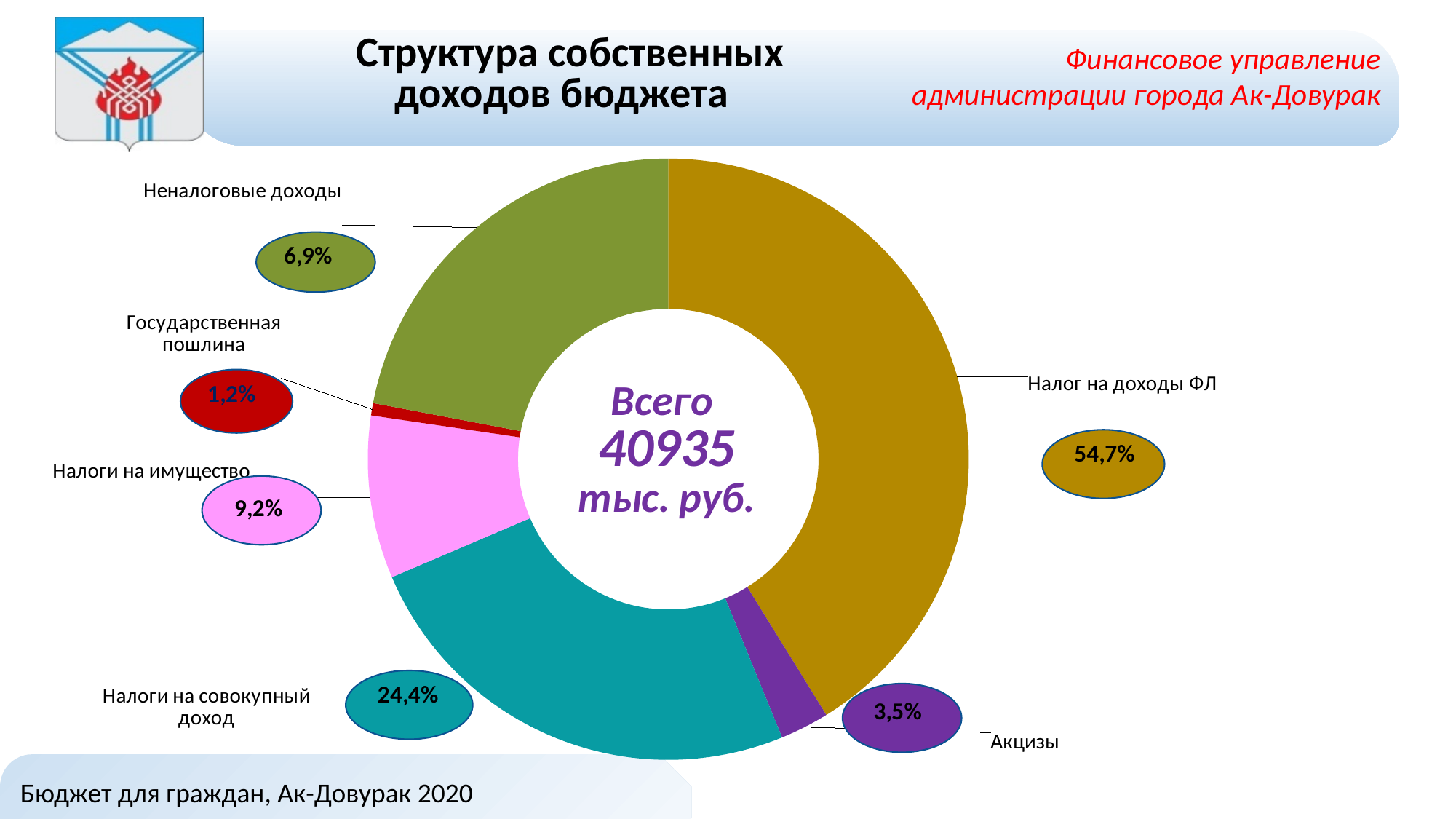
What is the share of Налоги на имущество? 9,2% How many percentage points larger is Налог на доходы ФЛ than Налоги на совокупный доход? 30,3 What total value is shown in the centre of the chart? 40935 тыс. руб. What percentage is shown for Налоги на совокупный доход? 24,4% What share of own budget revenues comes from Налог на доходы ФЛ? 54,7% Which category has the smallest share? Государственная пошлина How many categories are shown in the chart? 6 What type of chart is shown on the slide? Donut (pie) chart What percentage is shown for Неналоговые доходы? 6,9% What share does Государственная пошлина have? 1,2% Which category has the largest share of the budget's own revenues? Налог на доходы ФЛ